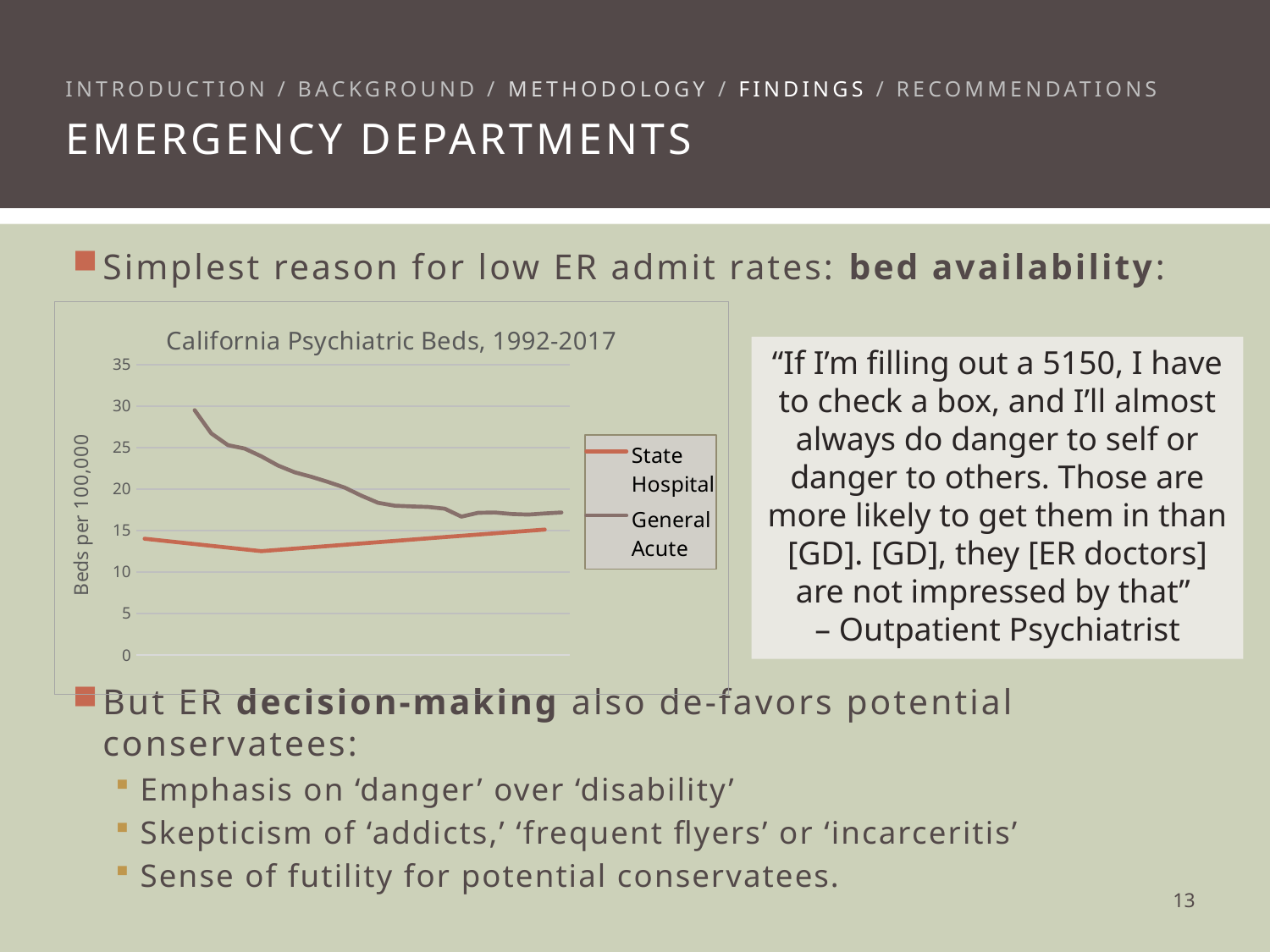
Is the lowest point of the State Hospital line greater or less than 15? less Which series has the higher values throughout the chart, State Hospital or General Acute? General Acute Does the General Acute line rise or fall from left to right across the chart? fall Is the starting value of the General Acute line greater or less than 25? greater What is the label on the chart's vertical axis? Beds per 100,000 Is the starting value of the State Hospital line greater or less than 20? less How many series does the chart's legend list? 2 What is the title of the chart? California Psychiatric Beds, 1992-2017 What are the two series named in the chart's legend? State Hospital and General Acute What kind of chart is shown on the slide? line chart